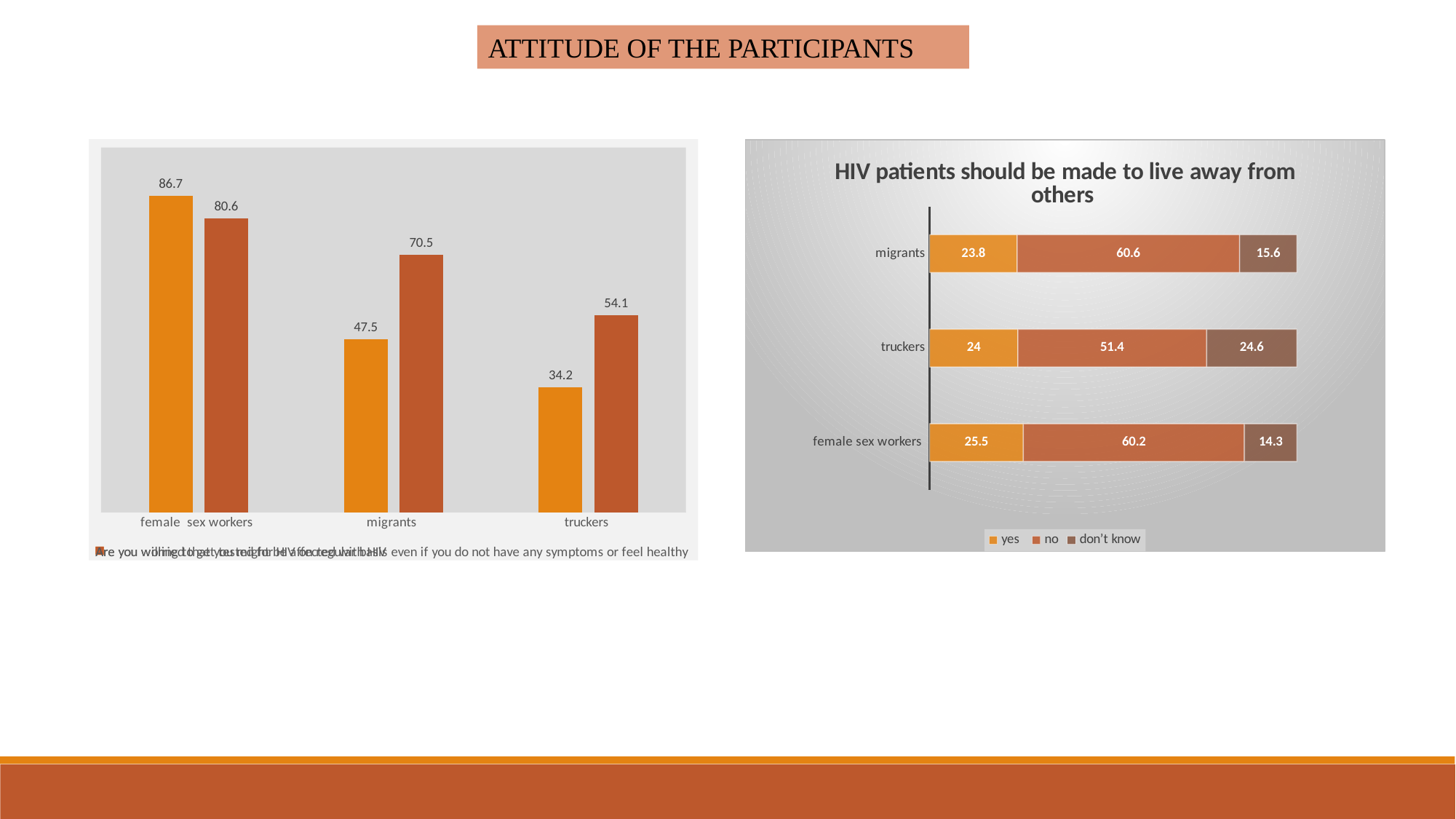
In the chart titled 'HIV patients should be made to live away from others', which group has the highest 'yes' value? female sex workers In the chart titled 'HIV patients should be made to live away from others', what is the difference between the 'no' values for migrants and truckers? 9.2 In the chart titled 'HIV patients should be made to live away from others', how many series does the legend list? 3 In the chart on the left of the slide, what is the value of the second (dark brown) bar for migrants? 70.5 In the chart on the left of the slide, what is the value of the first (orange) bar for female sex workers? 86.7 In the chart titled 'HIV patients should be made to live away from others', what is the 'no' value for migrants? 60.6 In the chart titled 'HIV patients should be made to live away from others', what is the total of the stacked bar for truckers? 100 In the chart titled 'HIV patients should be made to live away from others', what is the 'don't know' value for truckers? 24.6 In the chart titled 'HIV patients should be made to live away from others', which group has the lowest 'don't know' value? female sex workers In the chart on the left of the slide, what is the difference between the two bars for truckers? 19.9 In the chart on the left of the slide, which category has the lowest value for the first (orange) bar? truckers What kind of chart is the one on the left of the slide? bar chart